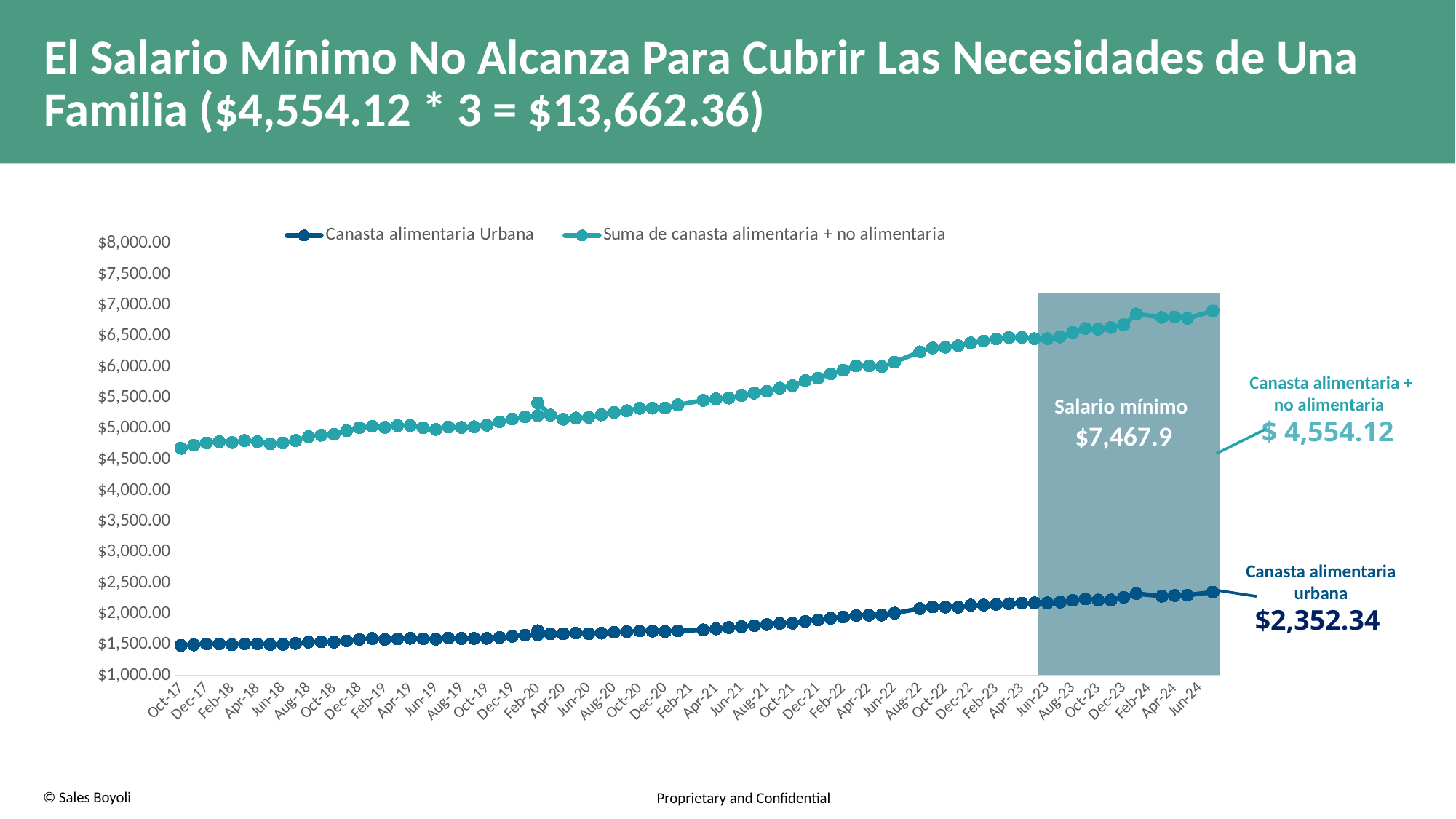
How many series does the chart legend list? 2 Is the value of Suma de canasta alimentaria + no alimentaria at Jun-24 greater or less than $6,500.00? greater Does the Canasta alimentaria Urbana series rise or fall from Oct-17 to Jun-24? rise Is the value of Suma de canasta alimentaria + no alimentaria at Oct-17 greater or less than $5,000.00? less What are the two series named in the chart legend? Canasta alimentaria Urbana; Suma de canasta alimentaria + no alimentaria What is the label of the shaded region on the right side of the chart? Salario mínimo What kind of chart is shown on the slide? line chart Does the Suma de canasta alimentaria + no alimentaria series rise or fall from Oct-17 to Jun-24? rise Is the value of Canasta alimentaria Urbana at Oct-17 greater or less than $2,000.00? less What value is annotated on the chart for Canasta alimentaria urbana? $2,352.34 What Salario mínimo value is printed in the shaded area of the chart? $7,467.9 Which series has higher values throughout the chart, Canasta alimentaria Urbana or Suma de canasta alimentaria + no alimentaria? Suma de canasta alimentaria + no alimentaria